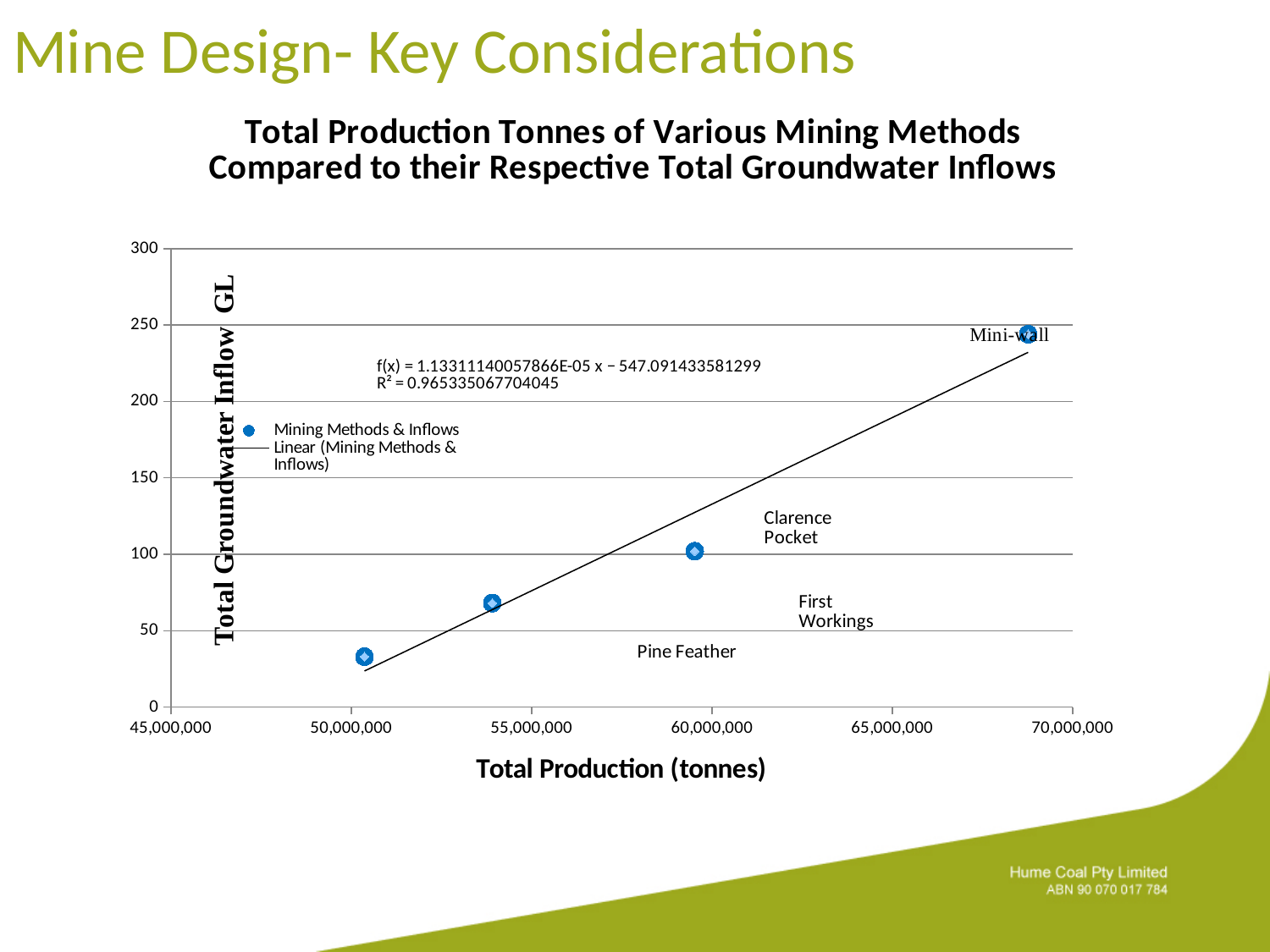
Is the total production for Mini-wall greater or less than 65,000,000 tonnes? greater How many entries does the chart legend list? 2 What is the R² value shown for the linear trendline? 0.965335067704045 Is the total groundwater inflow for Clarence Pocket greater or less than 150 GL? less How many data points are plotted in the chart? 4 Is the total groundwater inflow for Mini-wall greater or less than 200 GL? greater Which mining method has the lowest total groundwater inflow? Pine Feather What kind of chart is shown on the slide? scatter chart Does total groundwater inflow rise or fall as total production increases along the x axis? rise Which has the larger total groundwater inflow, Clarence Pocket or First Workings? Clarence Pocket Which mining method has the highest total groundwater inflow? Mini-wall